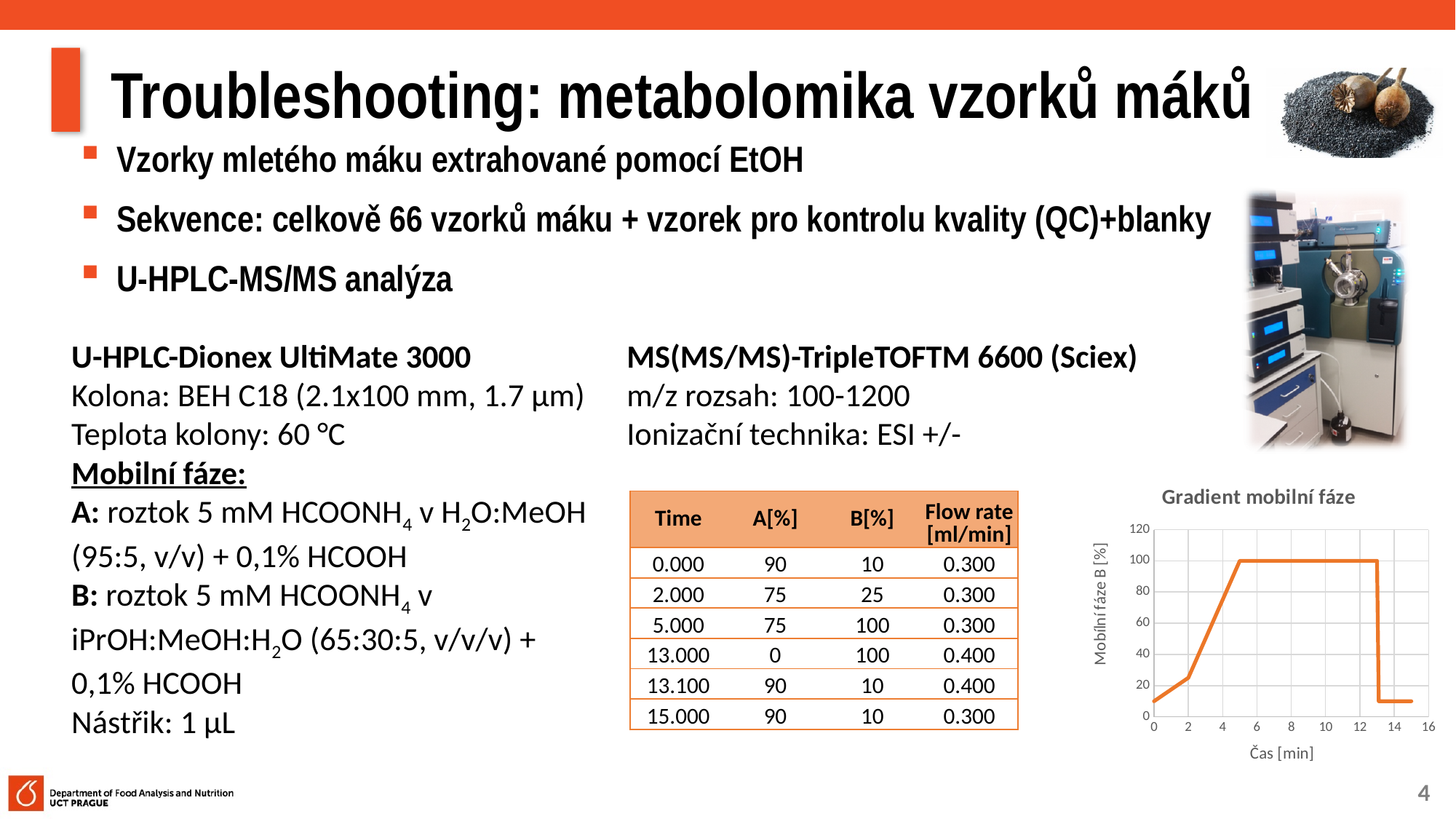
In the 'Gradient mobilní fáze' chart, is the value of Mobilní fáze B at 10 min greater or less than 80? greater What kind of chart is the 'Gradient mobilní fáze' chart? line chart What is the title of the chart on the slide? Gradient mobilní fáze In the 'Gradient mobilní fáze' chart, does the line rise or fall between 2 min and 5 min? rise In the 'Gradient mobilní fáze' chart, does the line rise or fall just after 13 min? fall In the 'Gradient mobilní fáze' chart, which is larger: the value of Mobilní fáze B at 8 min or at 14 min? 8 min In the 'Gradient mobilní fáze' chart, what is the highest value of Mobilní fáze B [%] reached by the line? 100 In the 'Gradient mobilní fáze' chart, is the value of Mobilní fáze B at 2 min greater or less than 40? less In the 'Gradient mobilní fáze' chart, is the value of Mobilní fáze B at 0 min greater or less than 20? less What is the label of the x axis of the 'Gradient mobilní fáze' chart? Čas [min]